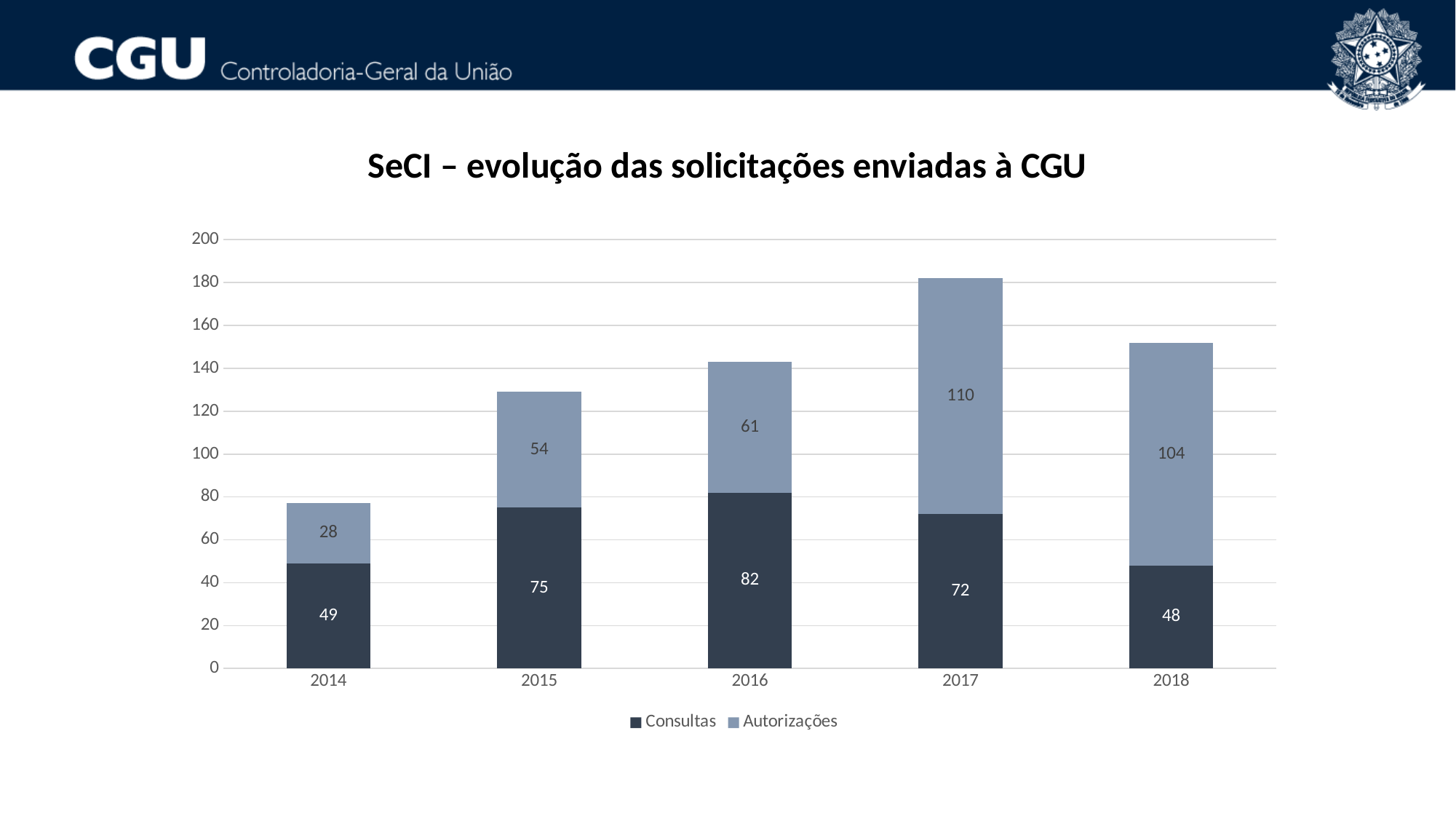
What type of chart is shown on the slide? Stacked bar chart What is the total of the stacked bar for 2017? 182 How many years are shown on the x axis? 5 Which year has the highest value for Autorizações? 2017 What is the difference between Autorizações in 2017 and Autorizações in 2016? 49 What is the total of the stacked bar for 2014? 77 Which is larger: Consultas in 2015 or Consultas in 2017? Consultas in 2015 What is the value of Autorizações for 2014? 28 What is the value of Consultas for 2016? 82 How many series does the legend list? 2 Which year has the lowest value for Consultas? 2018 What is the value of Autorizações for 2018? 104